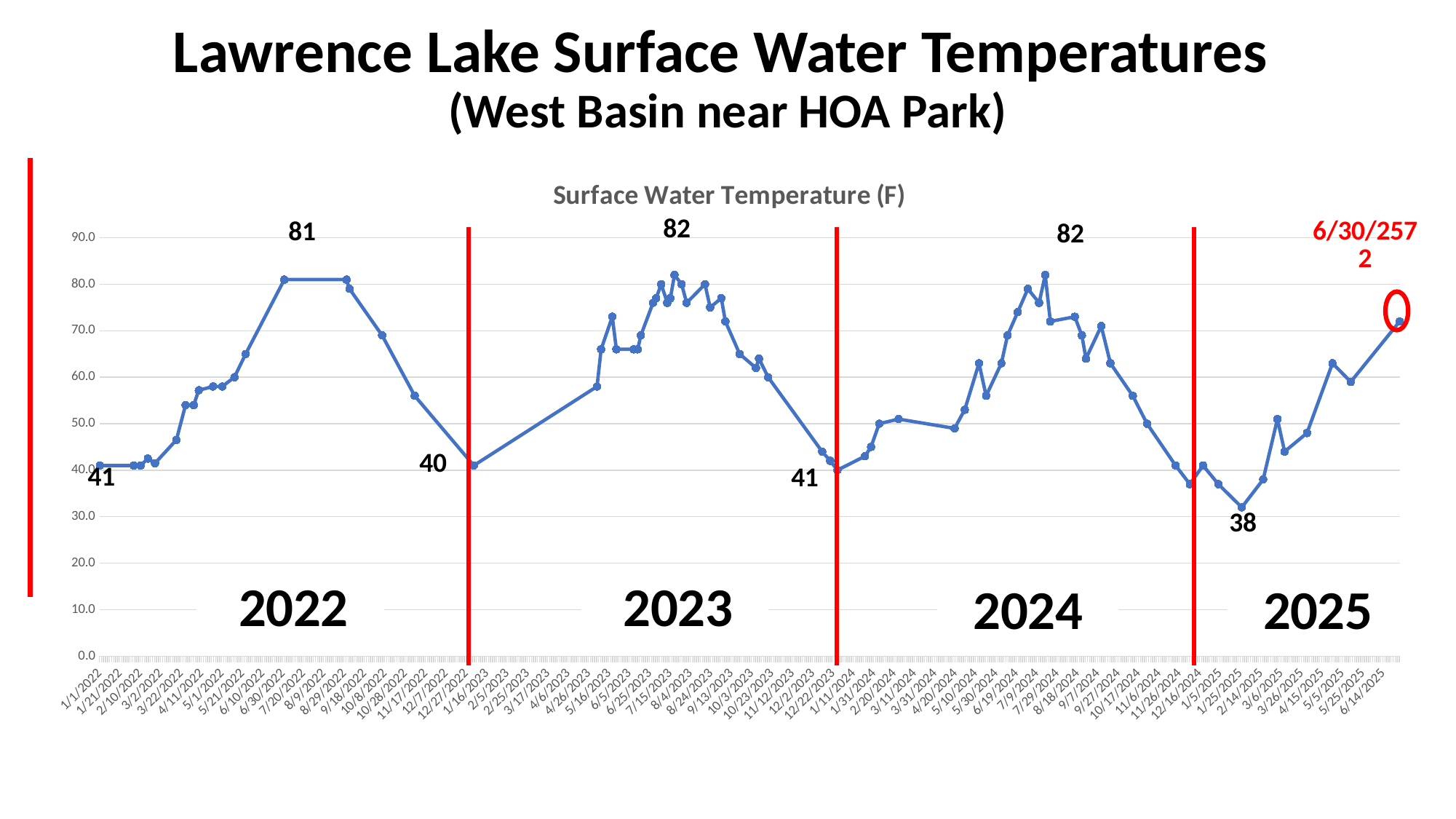
Does the surface water temperature rise or fall from 1/1/2022 to 7/20/2022? rises What is the labeled peak surface water temperature in 2023? 82 Which year has the lowest labeled minimum temperature? 2025 What is the difference between the labeled 2023 peak and the labeled 2022 peak? 1 Is the value for 1/25/2025 greater or less than 40? less What is the labeled peak surface water temperature in 2024? 82 What kind of chart is shown on the slide? line chart What is the labeled peak surface water temperature in 2022? 81 What is the labeled low surface water temperature in 2025? 38 What is the labeled surface water temperature at the start of 2022? 41 Which year had the higher labeled peak temperature, 2022 or 2023? 2023 What is the title printed above the plot area of the chart? Surface Water Temperature (F)